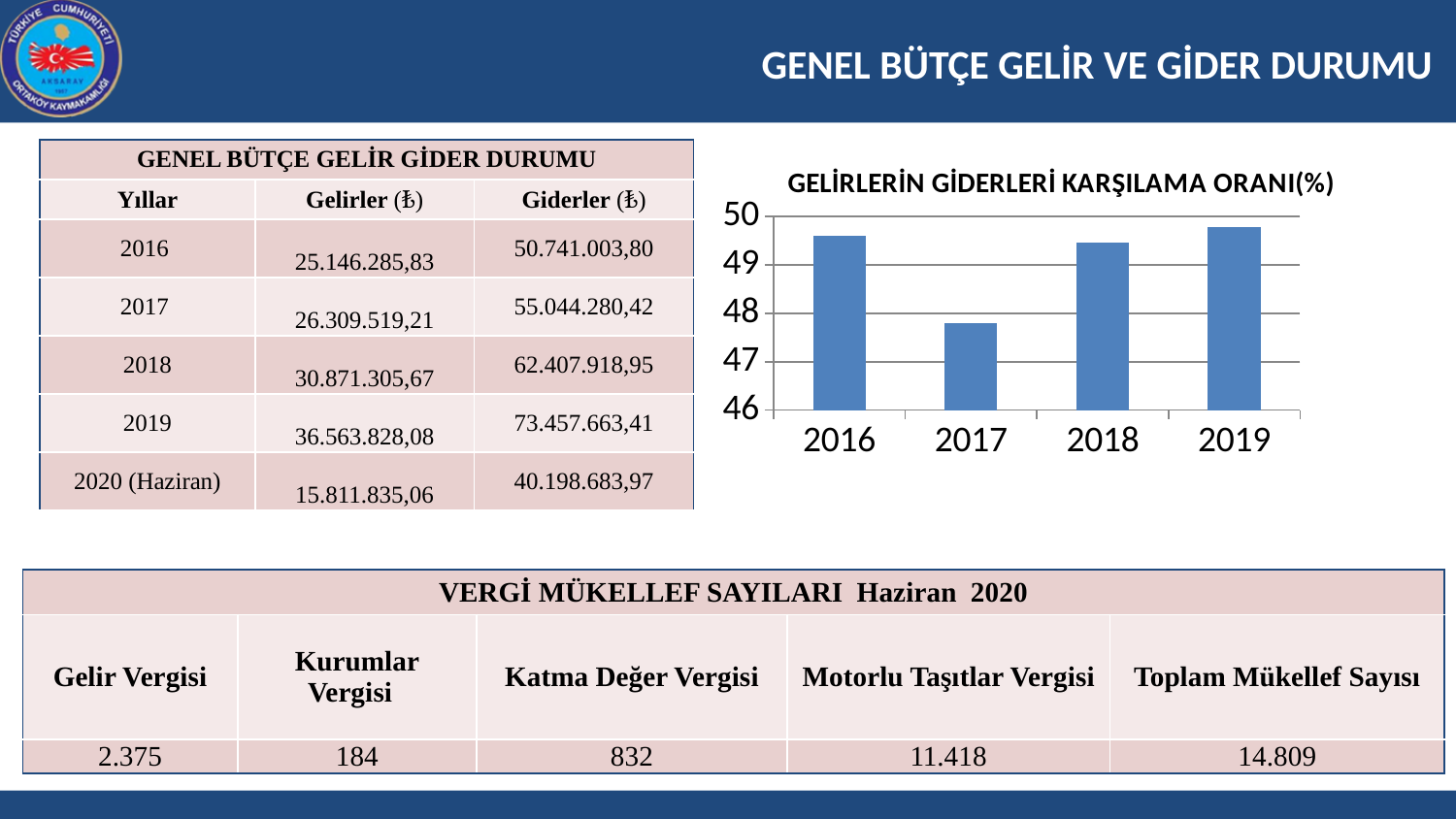
What kind of chart is shown on the slide? bar chart Is the value for 2018 greater or less than 49? greater Is the value for 2016 greater or less than 49? greater Is the value for 2019 greater or less than 49? greater What is the title of the chart? GELİRLERİN GİDERLERİ KARŞILAMA ORANI(%) Which is larger, the value for 2017 or the value for 2018? 2018 Which is larger, the value for 2016 or the value for 2017? 2016 How many years are shown on the x axis of the chart? 4 What is the lowest value shown on the vertical axis of the chart? 46 Which year has the lowest value in the chart? 2017